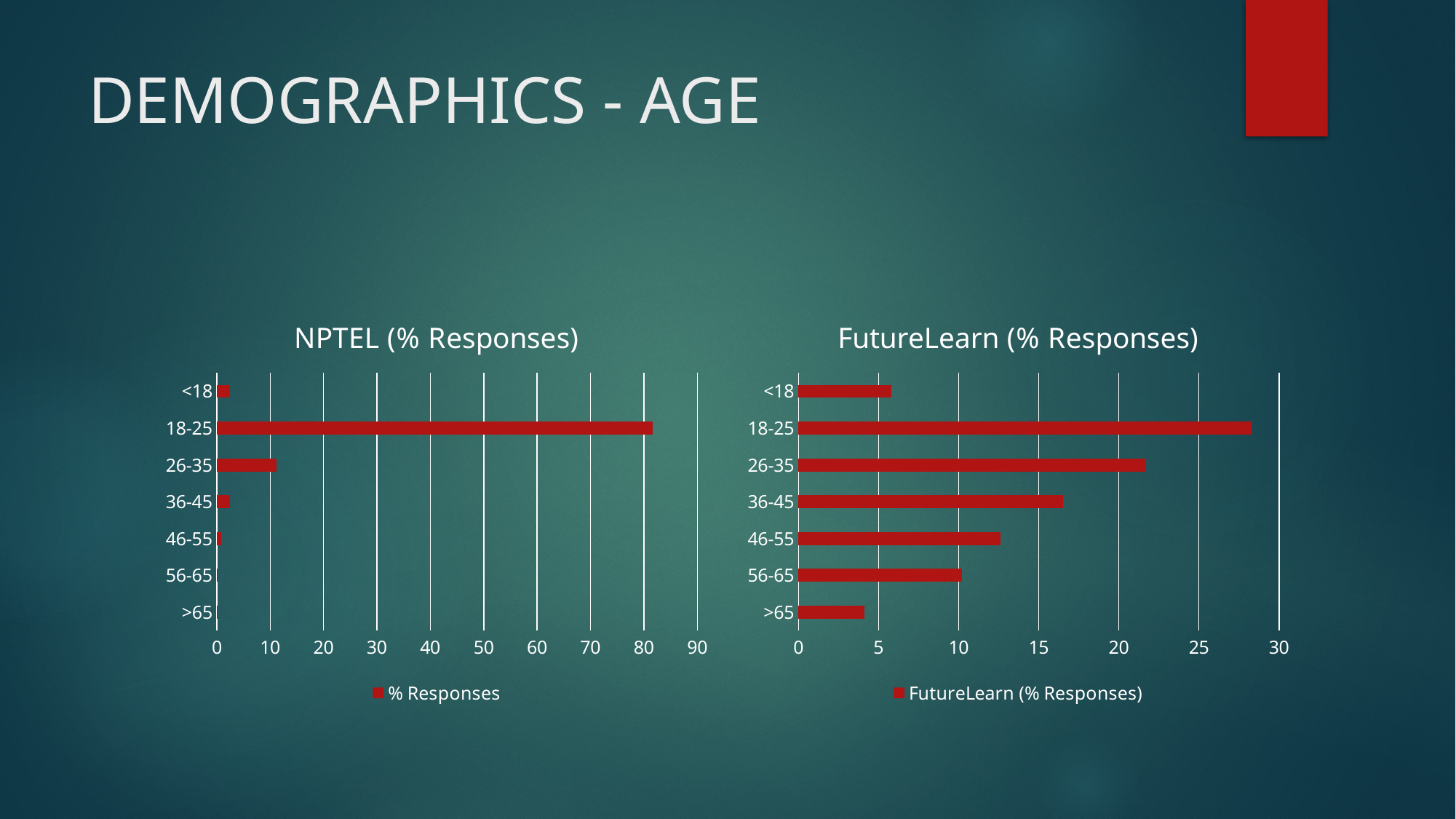
How many series does the legend of the FutureLearn (% Responses) chart list? 1 In the NPTEL (% Responses) chart, which age group has the highest value? 18-25 In the FutureLearn (% Responses) chart, is the value for 46-55 greater or less than 15? less In the FutureLearn (% Responses) chart, which age group has the highest value? 18-25 In the FutureLearn (% Responses) chart, which is larger, the value for 36-45 or the value for 56-65? 36-45 In the FutureLearn (% Responses) chart, which age group has the lowest value? >65 In the NPTEL (% Responses) chart, is the value for 18-25 greater or less than 80? greater In the FutureLearn (% Responses) chart, is the value for 26-35 greater or less than 20? greater In the FutureLearn (% Responses) chart, do the values rise or fall from the 18-25 group down to the >65 group? fall How many age groups are shown in the NPTEL (% Responses) chart? 7 What kind of chart is the NPTEL (% Responses) chart? bar chart